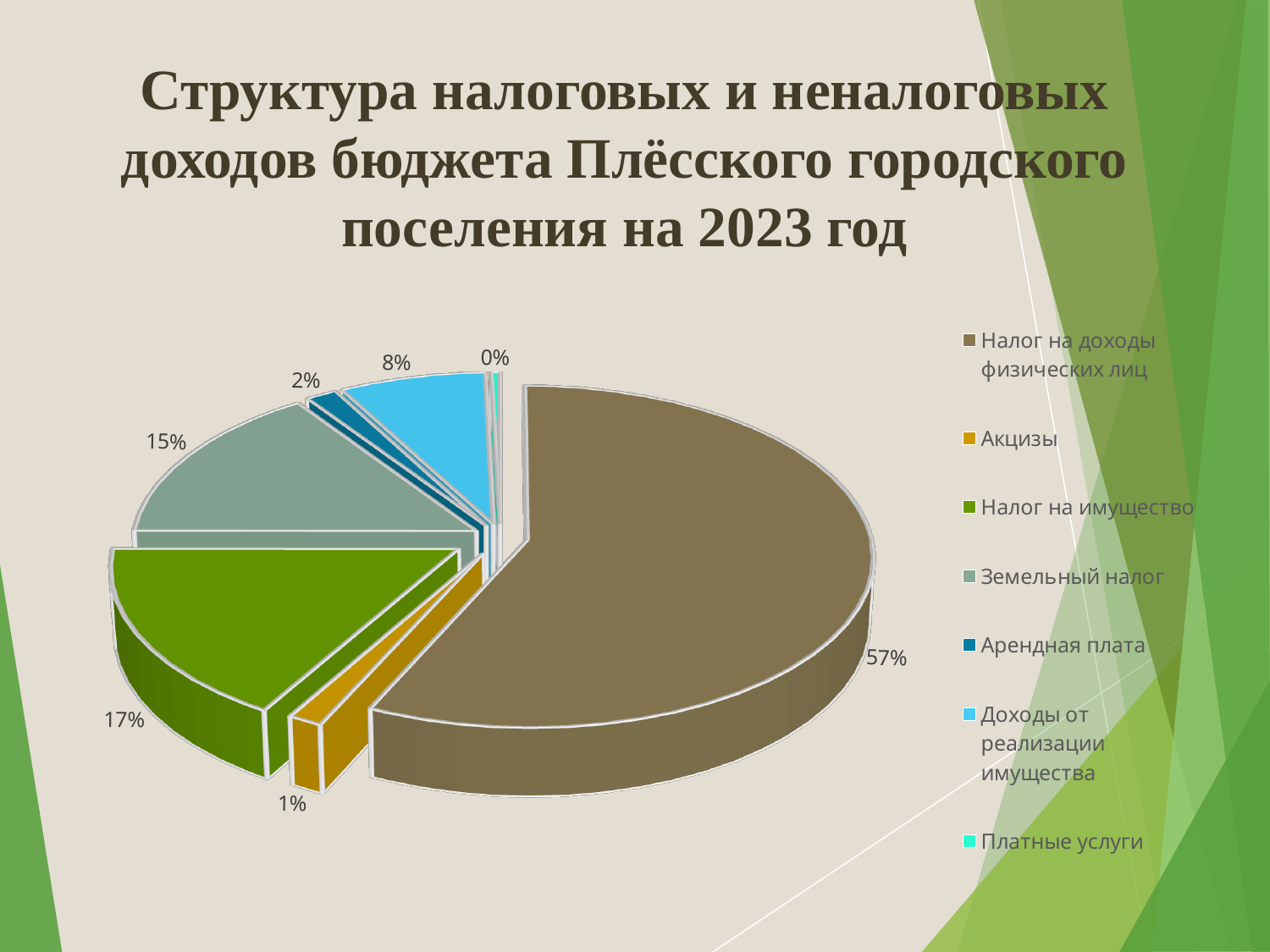
Which category has the smallest slice of the pie? Платные услуги What share of the pie does Акцизы have? 1% What share of the pie does Доходы от реализации имущества have? 8% What kind of chart is shown on the slide? Pie chart What is the title of the slide? Структура налоговых и неналоговых доходов бюджета Плёсского городского поселения на 2023 год What share of the pie does Налог на доходы физических лиц have? 57% Which category has the largest slice of the pie? Налог на доходы физических лиц What share of the pie does Налог на имущество have? 17% Which is larger, the share for Арендная плата or the share for Доходы от реализации имущества? Доходы от реализации имущества How many categories does the legend list? 7 What is the difference in percentage points between Налог на имущество and Земельный налог? 2 What share of the pie does Земельный налог have? 15%